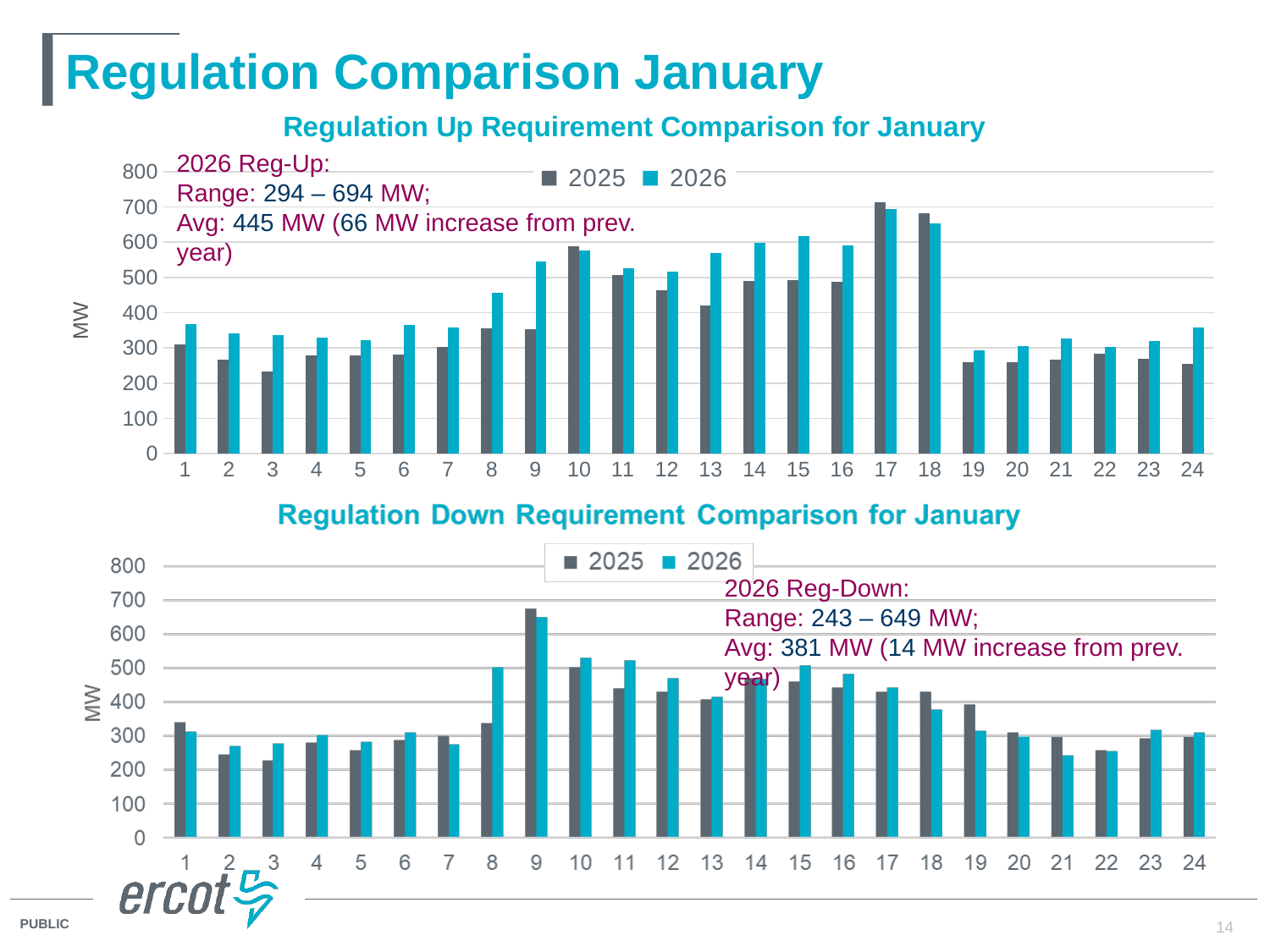
In the Regulation Down Requirement Comparison for January chart, is the 2026 value for hour 21 greater or less than 300? less What are the two legend entries in the Regulation Up Requirement Comparison for January chart? 2025 and 2026 How many series does the legend of the Regulation Down Requirement Comparison for January chart list? 2 In the Regulation Up Requirement Comparison for January chart, which hour has the highest 2025 value? 17 In the Regulation Down Requirement Comparison for January chart, which hour has the highest 2026 value? 9 In the Regulation Up Requirement Comparison for January chart, which series has the larger value at hour 8, 2025 or 2026? 2026 In the Regulation Down Requirement Comparison for January chart, which series has the larger value at hour 18, 2025 or 2026? 2025 In the Regulation Up Requirement Comparison for January chart, is the 2025 value for hour 3 greater or less than 300? less What kind of chart is the Regulation Up Requirement Comparison for January? bar chart How many hour categories are shown on the x axis of the Regulation Up Requirement Comparison for January chart? 24 In the Regulation Up Requirement Comparison for January chart, is the 2025 value for hour 17 greater or less than 600? greater